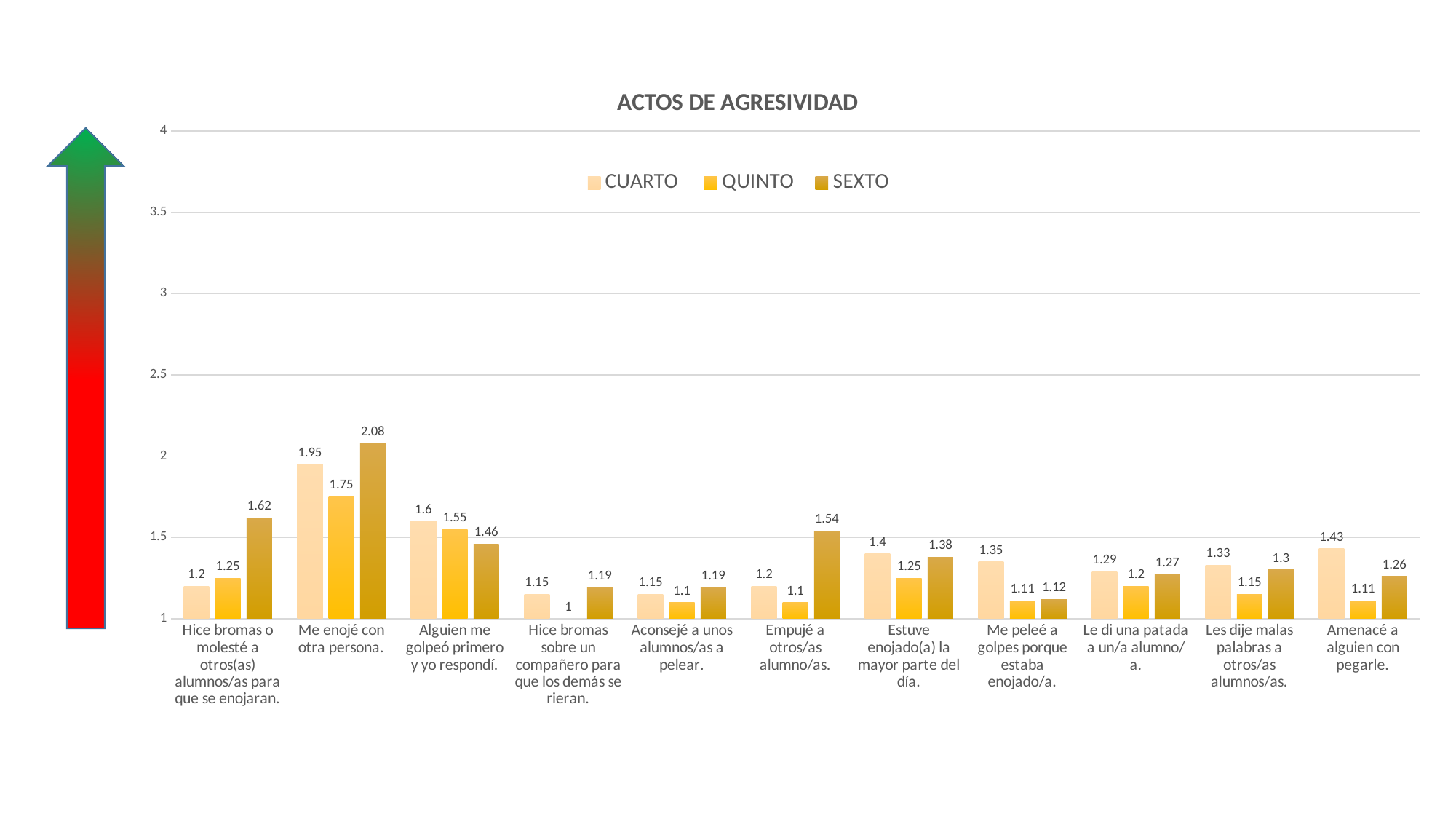
How many categories are shown on the x axis? 11 Is the SEXTO value for 'Me enojé con otra persona.' greater or less than 2? greater What is the SEXTO value for 'Me enojé con otra persona.'? 2.08 What is the difference between the SEXTO and CUARTO values for 'Empujé a otros/as alumno/as.'? 0.34 What kind of chart is shown on the slide? bar chart Which category has the lowest QUINTO value? Hice bromas sobre un compañero para que los demás se rieran. How many series does the legend list? 3 For 'Alguien me golpeó primero y yo respondí.', which is larger, the CUARTO value or the SEXTO value? CUARTO What is the QUINTO value for 'Hice bromas sobre un compañero para que los demás se rieran.'? 1 What is the CUARTO value for 'Amenacé a alguien con pegarle.'? 1.43 Which category has the highest CUARTO value? Me enojé con otra persona. What is the title of the chart? ACTOS DE AGRESIVIDAD